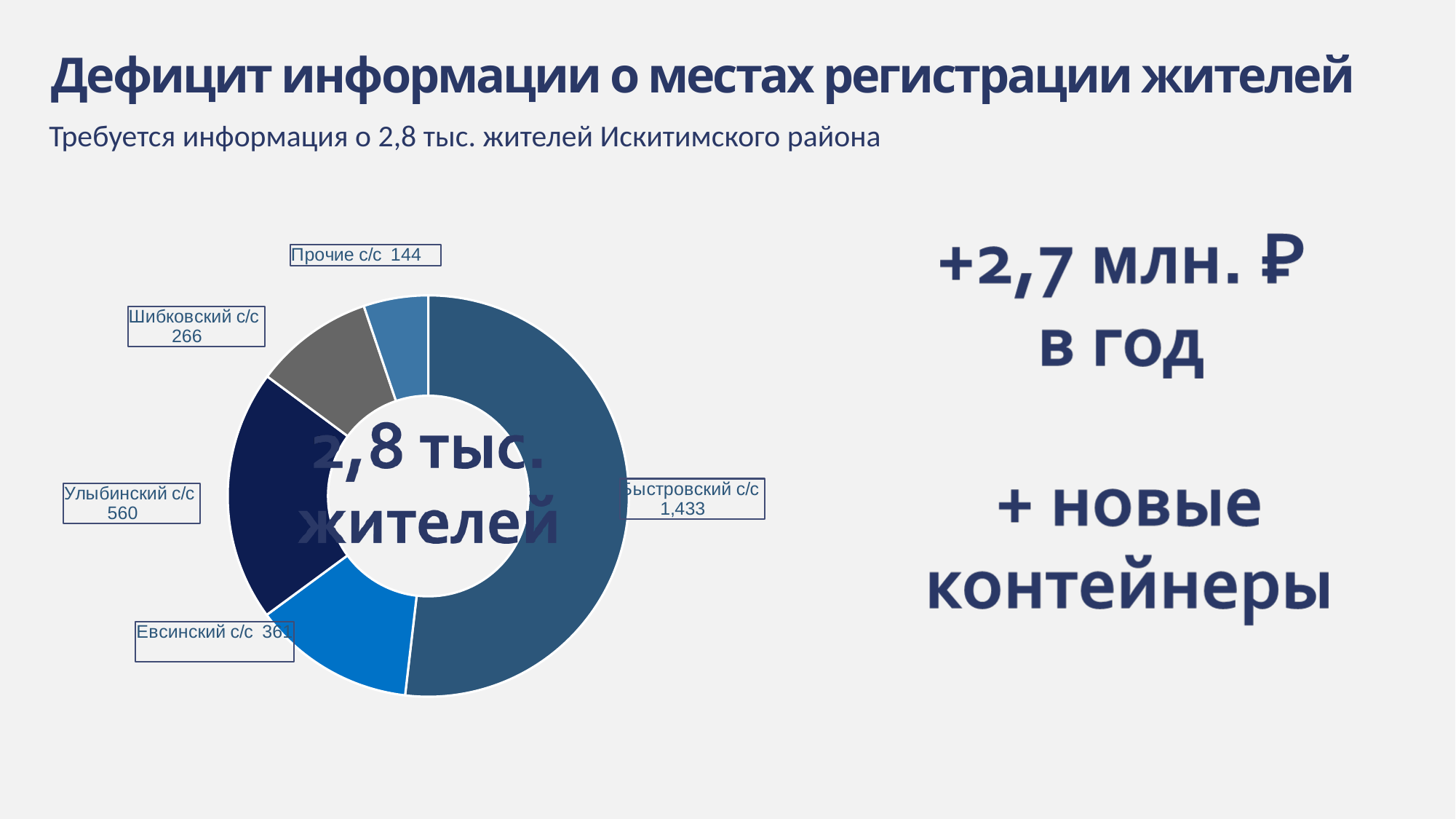
How many categories are shown in the chart? 5 Which is larger, Шибковский с/с or Прочие с/с? Шибковский с/с What is the value for Улыбинский с/с? 560 Which category has the largest slice? Быстровский с/с What text is shown in the centre of the donut chart? 2,8 тыс. жителей What kind of chart is shown on the slide? Pie (donut) chart What is the value for Шибковский с/с? 266 What is the difference between Быстровский с/с and Улыбинский с/с? 873 What is the value for Быстровский с/с? 1,433 What is the value for Прочие с/с? 144 Which category has the smallest slice? Прочие с/с What is the difference between Улыбинский с/с and Шибковский с/с? 294